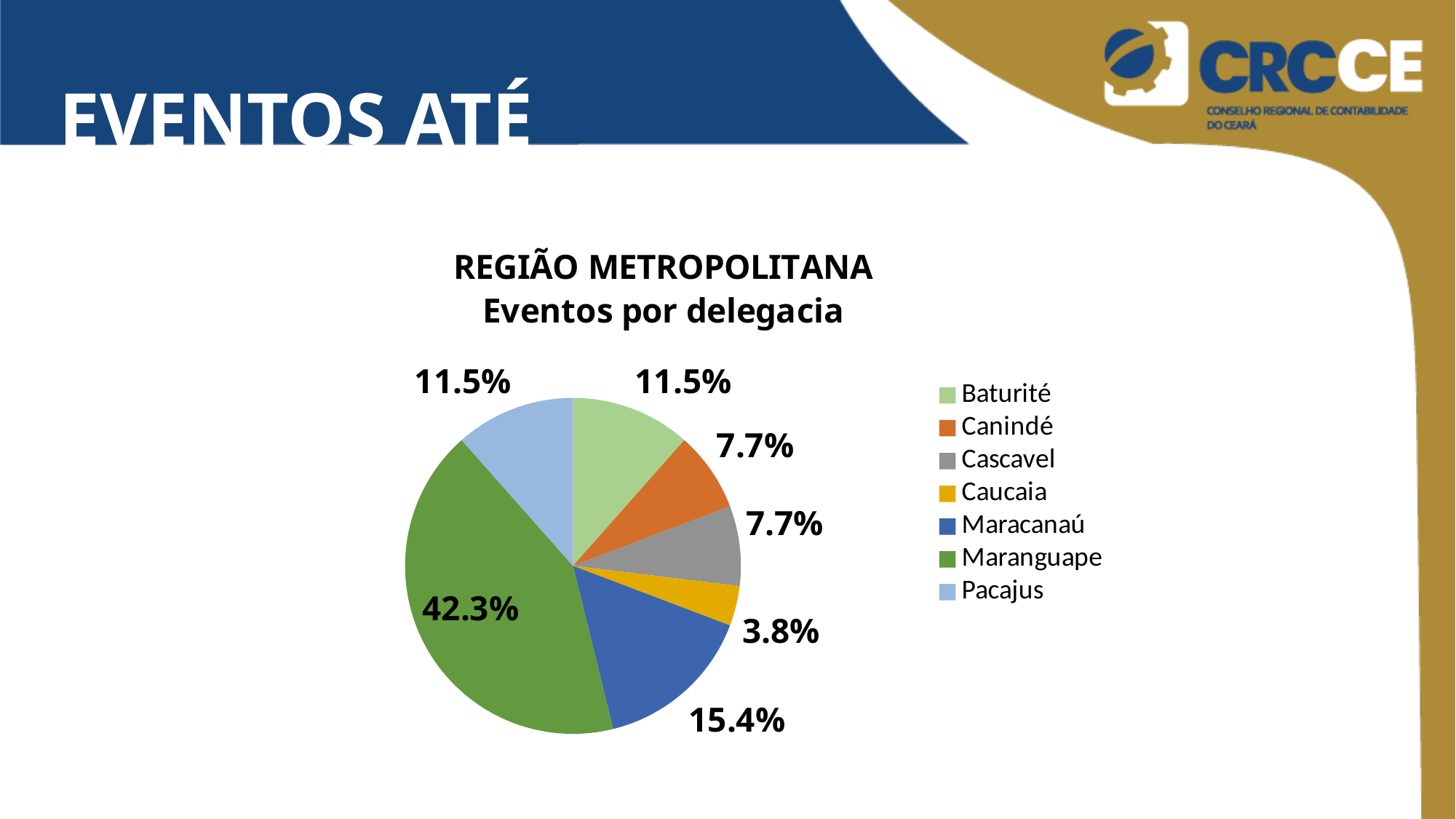
Which is larger, the share for Baturité or the share for Canindé? Baturité What is the title of the chart? REGIÃO METROPOLITANA Eventos por delegacia What colour is the slice for Caucaia? Yellow What is the value shown for Caucaia? 3.8% How many delegacias are shown in the pie chart? 7 What is the value shown for Pacajus? 11.5% What share of the pie does Maranguape have? 42.3% Which delegacia has the smallest slice of the pie? Caucaia What is the value shown for Maracanaú? 15.4% What type of chart is shown on the slide? Pie chart Which delegacia has the largest slice of the pie? Maranguape What is the difference between the shares of Maranguape and Maracanaú? 26.9%